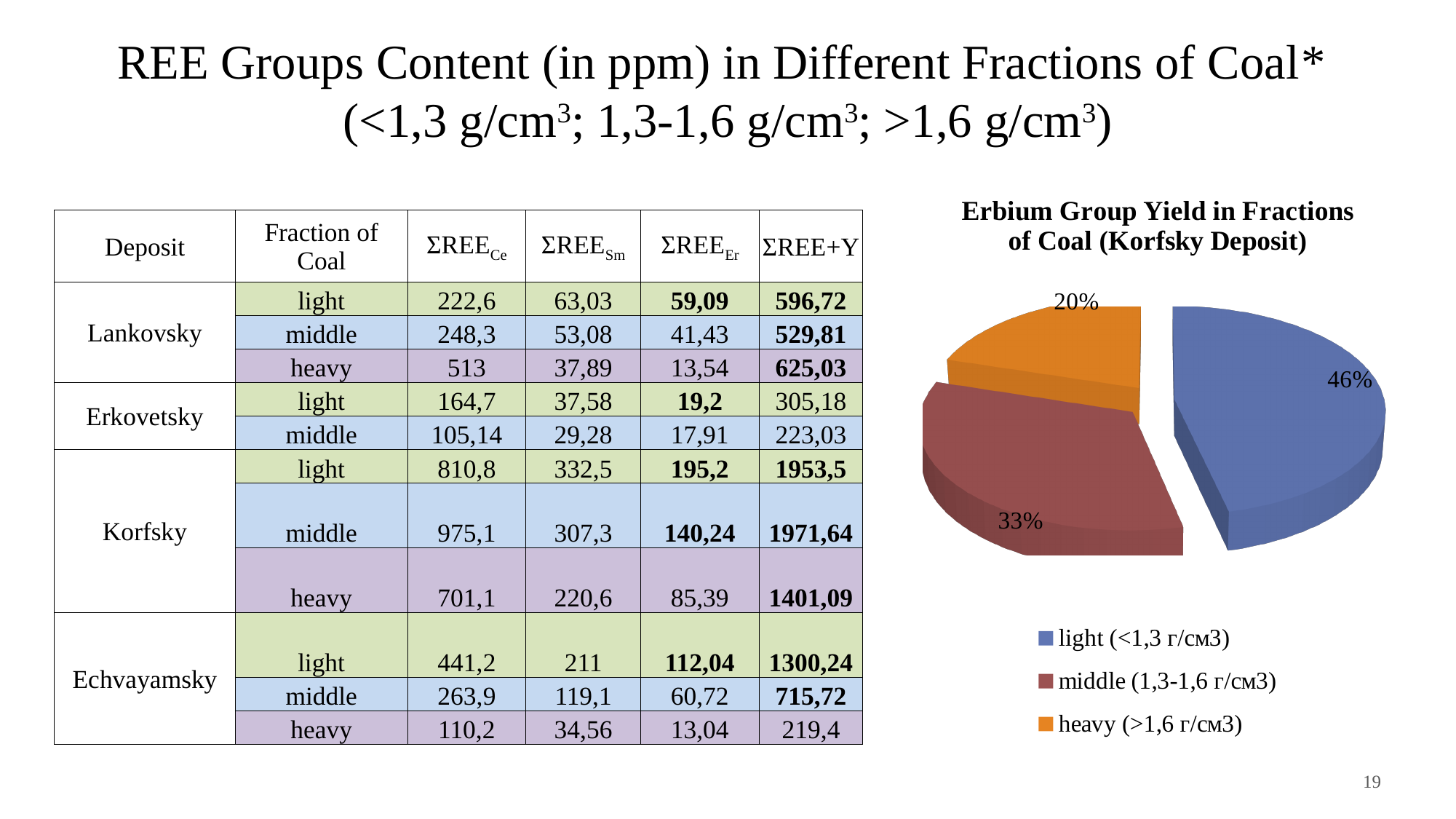
What is the difference in percentage points between the light and heavy fraction shares? 26% How many slices does the pie chart have? 3 What share of the pie does the heavy (>1,6 г/см3) fraction have? 20% Which is larger, the share of the middle fraction or the share of the heavy fraction? middle fraction What kind of chart is shown on the slide? pie chart What is the title of the chart? Erbium Group Yield in Fractions of Coal (Korfsky Deposit) How many entries does the legend list? 3 Which fraction has the smallest slice of the pie? heavy (>1,6 г/см3) What share of the pie does the light (<1,3 г/см3) fraction have? 46% What share of the pie does the middle (1,3-1,6 г/см3) fraction have? 33% Which fraction has the largest slice of the pie? light (<1,3 г/см3) What colour is the slice for the heavy (>1,6 г/см3) fraction? orange